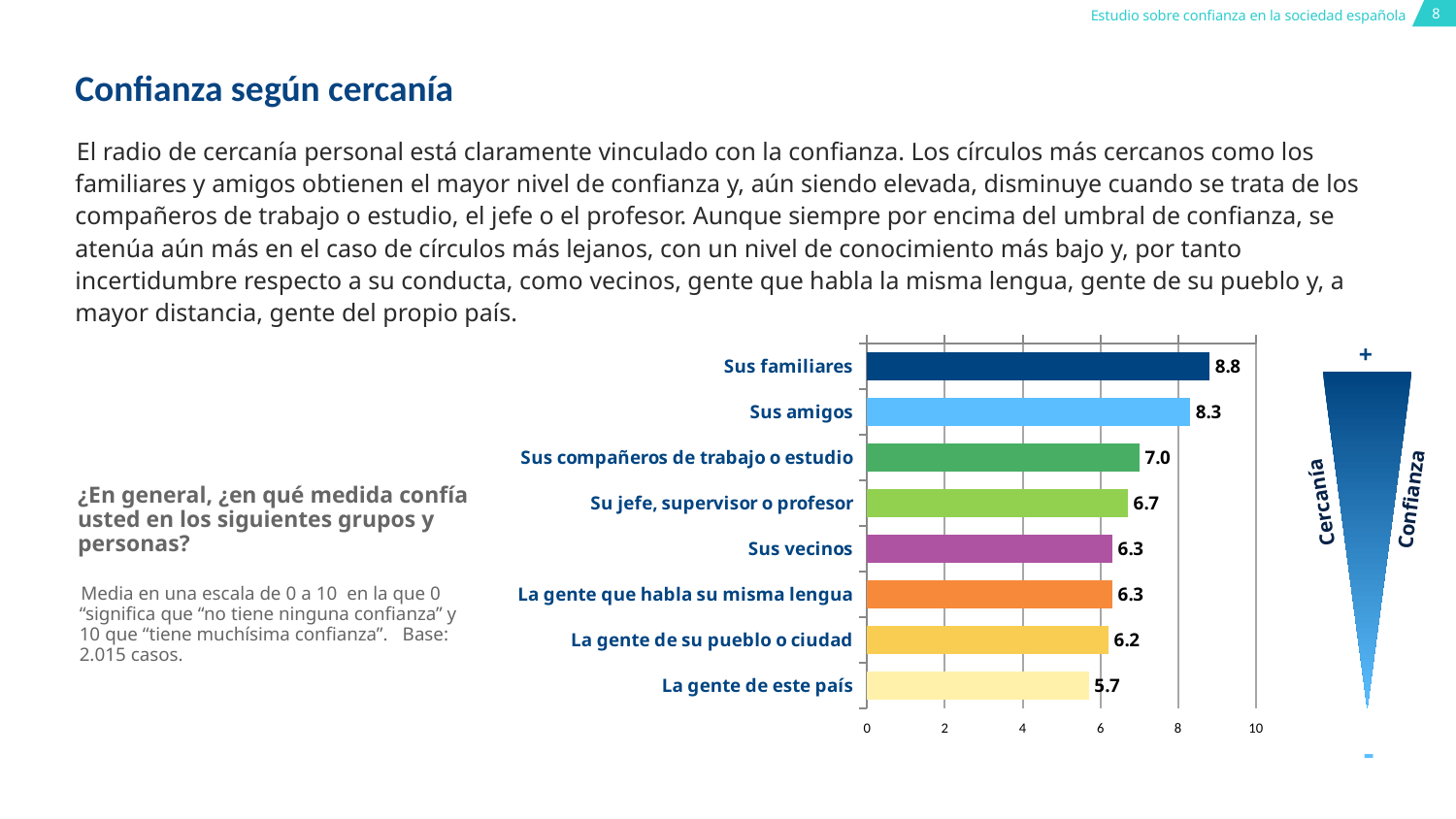
Which category has the lowest value? La gente de este país What is the difference between the values for "Sus compañeros de trabajo o estudio" and "La gente de este país"? 1.3 What is the maximum value shown on the horizontal axis of the chart? 10 How many categories are shown in the chart? 8 Which category has the highest value? Sus familiares What is the difference between the values for "Sus familiares" and "Sus amigos"? 0.5 What is the value for "Sus vecinos"? 6.3 Which is larger, the value for "Sus amigos" or the value for "Sus compañeros de trabajo o estudio"? Sus amigos What is the value for "La gente de este país"? 5.7 What is the value for "Su jefe, supervisor o profesor"? 6.7 What kind of chart is shown on the slide? Bar chart What is the value for "Sus familiares"? 8.8